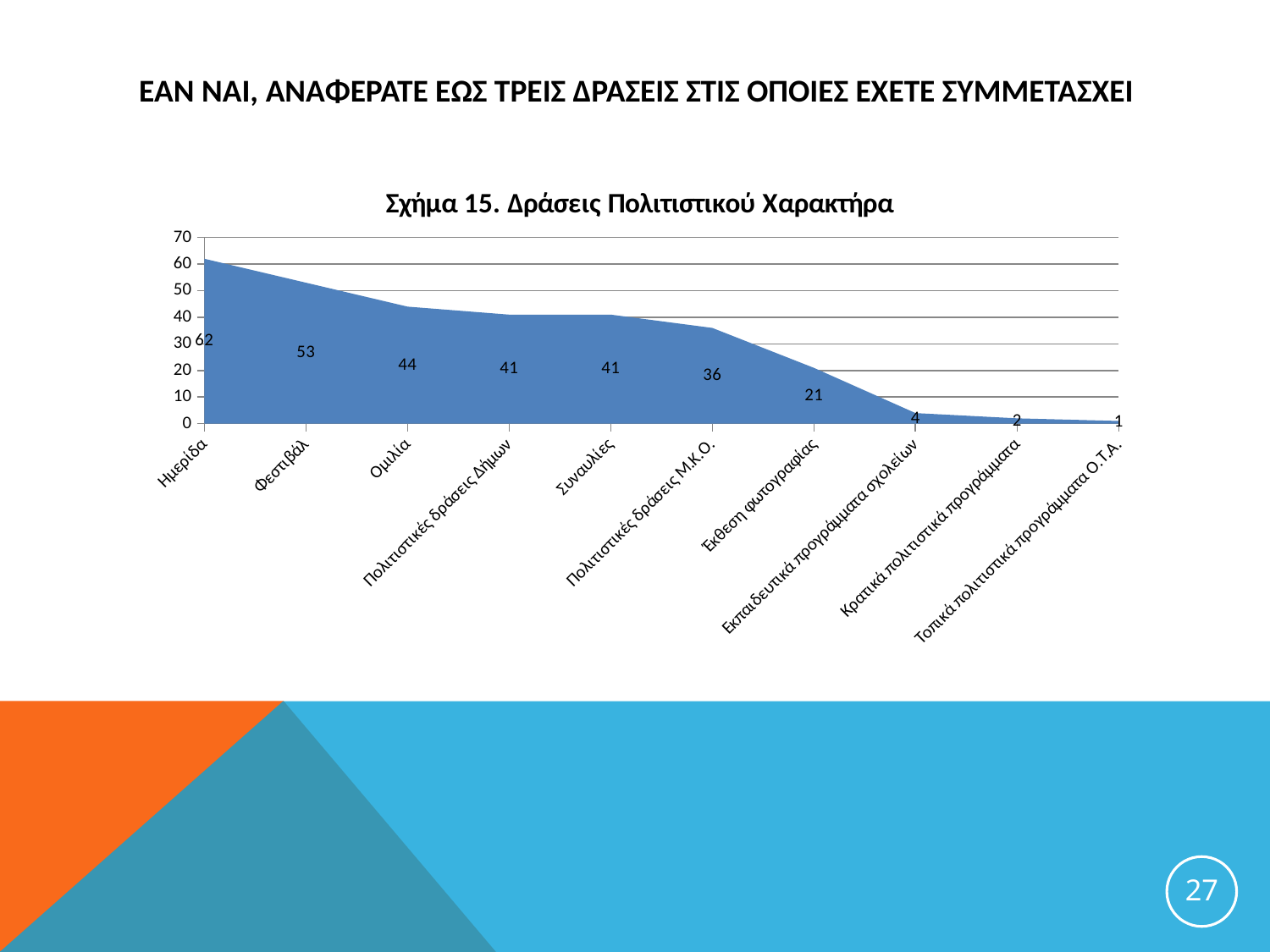
Which is larger, the value for Ομιλία or the value for Συναυλίες? Ομιλία What is the difference between the values for Ημερίδα and Φεστιβάλ? 9 What is the value for Πολιτιστικές δράσεις Μ.Κ.Ο.? 36 What is the value for Ημερίδα? 62 What is the value for Φεστιβάλ? 53 What is the value for Έκθεση φωτογραφίας? 21 What is the title of the chart? Σχήμα 15. Δράσεις Πολιτιστικού Χαρακτήρα What kind of chart is this? area chart Is the value for Ομιλία greater or less than 40? greater Which category has the lowest value? Τοπικά πολιτιστικά προγράμματα Ο.Τ.Α. Which category has the highest value? Ημερίδα How many categories are shown on the x axis? 10